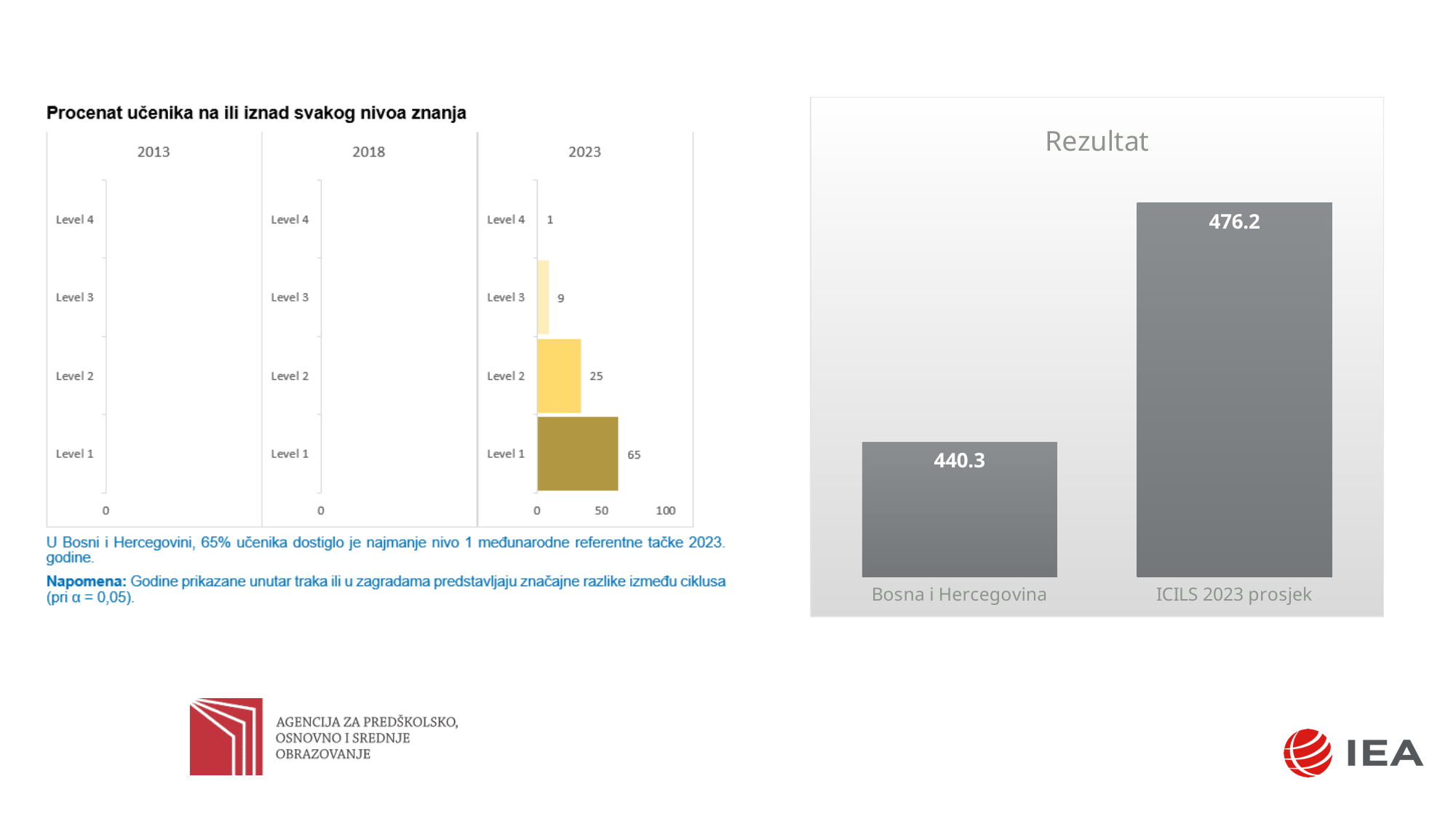
In the 'Rezultat' chart, what is the value for Bosna i Hercegovina? 440.3 In the 'Procenat učenika na ili iznad svakog nivoa znanja' chart, what is the value for Level 2 in 2023? 25 In the 'Procenat učenika na ili iznad svakog nivoa znanja' chart, which level has the lowest value in 2023? Level 4 In the 'Rezultat' chart, what is the difference between ICILS 2023 prosjek and Bosna i Hercegovina? 35.9 In the 'Procenat učenika na ili iznad svakog nivoa znanja' chart, what is the value for Level 3 in 2023? 9 What kind of chart is the 'Rezultat' chart? Bar chart In the 'Rezultat' chart, what is the value for ICILS 2023 prosjek? 476.2 In the 'Procenat učenika na ili iznad svakog nivoa znanja' chart, what is the value for Level 4 in 2023? 1 In the 'Rezultat' chart, how many bars are plotted? 2 In the 'Procenat učenika na ili iznad svakog nivoa znanja' chart, what is the value for Level 1 in 2023? 65 In the 'Procenat učenika na ili iznad svakog nivoa znanja' chart, what is the difference between Level 1 and Level 2 in 2023? 40 In the 'Rezultat' chart, which category has the higher value? ICILS 2023 prosjek